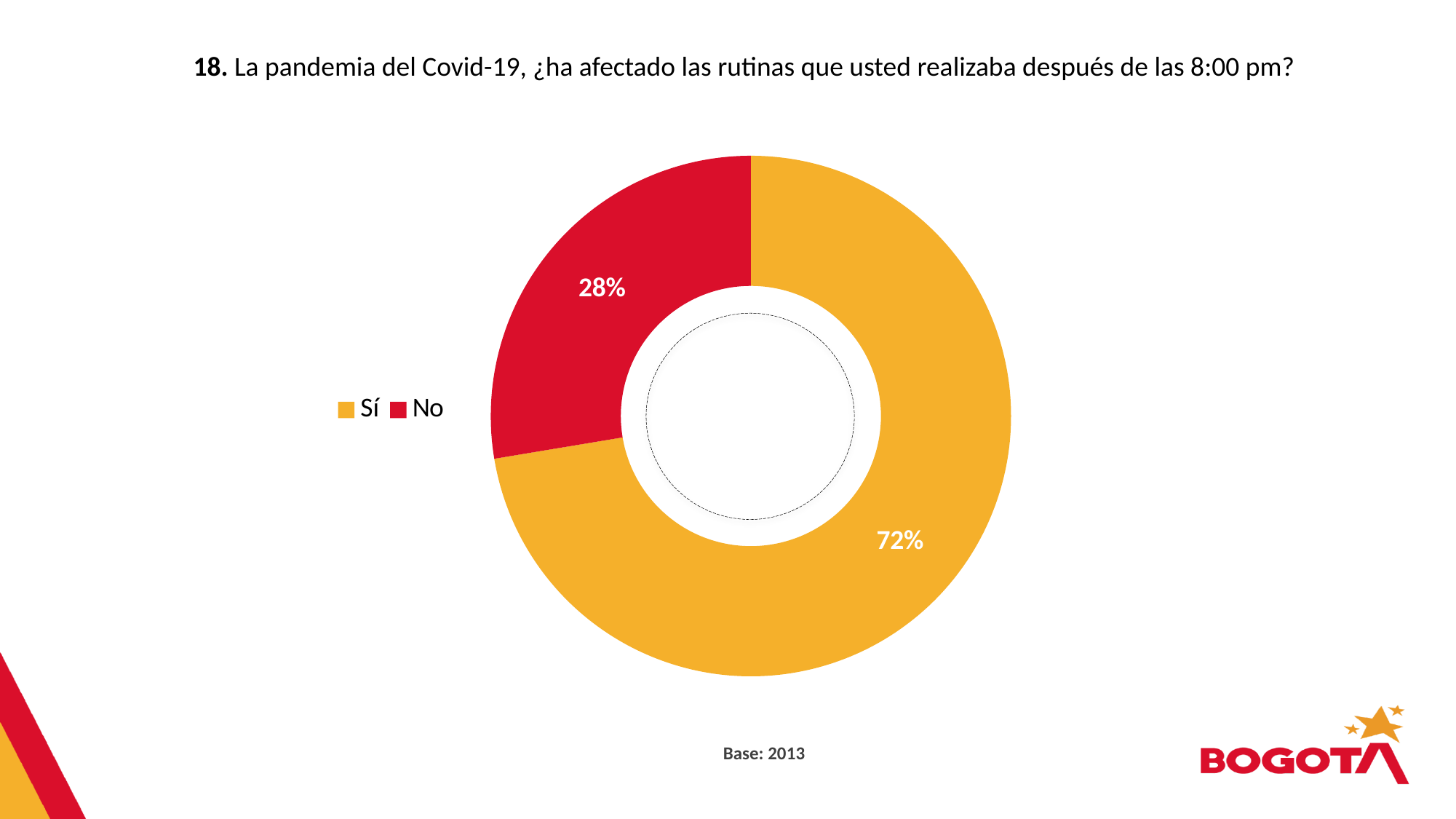
Which response has the largest share of the chart? Sí Which response has the smallest share of the chart? No What base (number of respondents) is stated below the chart? 2013 What share of the pie does the "No" slice represent? 28% What percentage of respondents answered "No"? 28% What percentage of respondents answered "Sí"? 72% What colour is used for the "Sí" slice? Yellow/orange How many categories does the chart show? 2 Which is larger, the share for "Sí" or the share for "No"? Sí What is the difference in percentage points between the "Sí" and "No" shares? 44 What kind of chart is shown on the slide? Pie chart (doughnut)